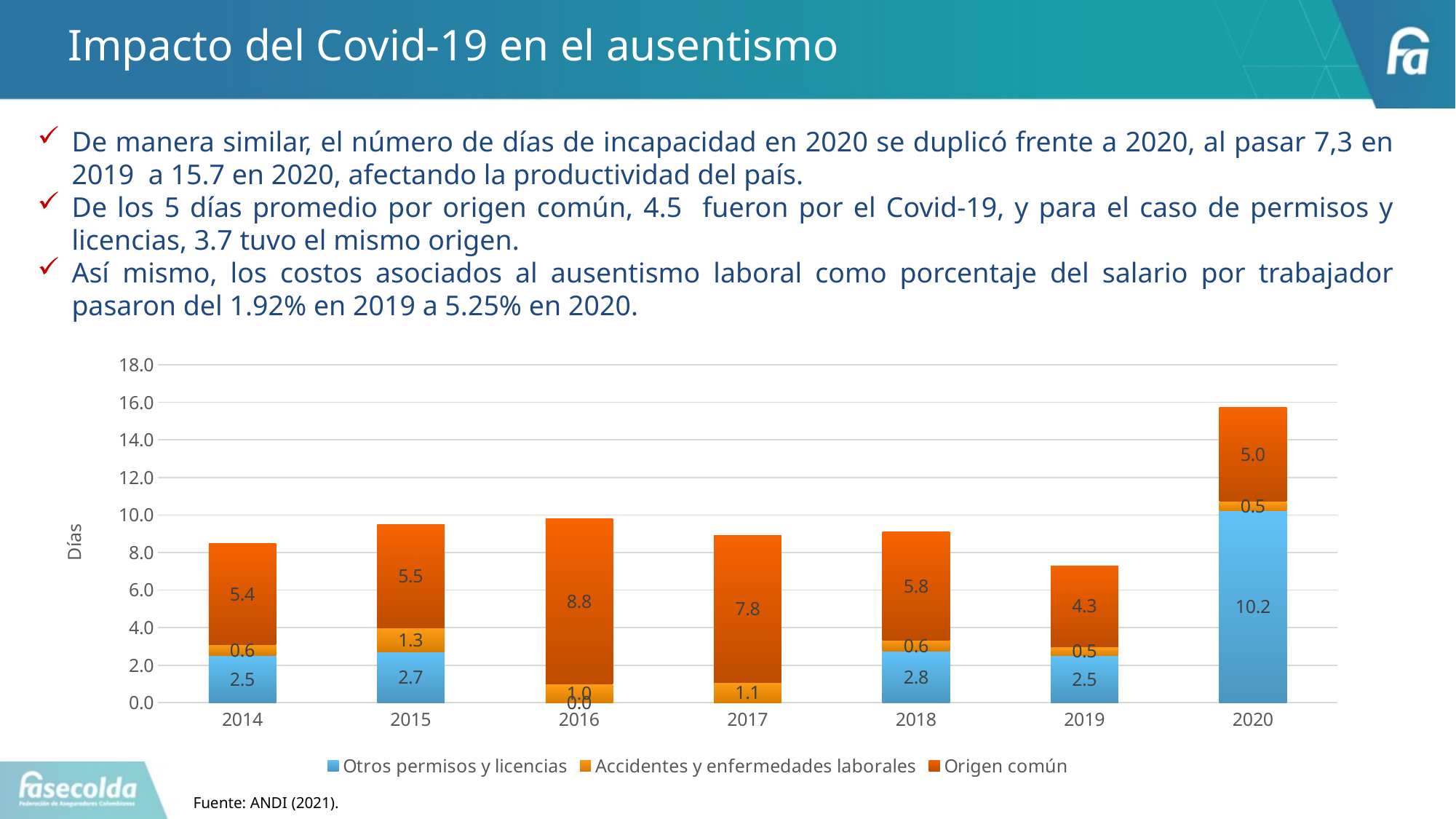
In which year is the Origen común value the highest? 2016 What is the value for Accidentes y enfermedades laborales in 2015? 1.3 Is the total height of the 2020 stacked bar greater or less than 14.0? greater What is the value for Origen común in 2016? 8.8 What is the total of the stacked bar for 2019? 7.3 What is the difference between the Otros permisos y licencias values for 2020 and 2019? 7.7 In which year is the Origen común value the lowest? 2019 What is the value for Otros permisos y licencias in 2020? 10.2 Which is larger, the Origen común value for 2018 or for 2019? 2018 How many series does the legend list? 3 How many years are shown on the x axis? 7 What kind of chart is shown on the slide? Stacked bar chart